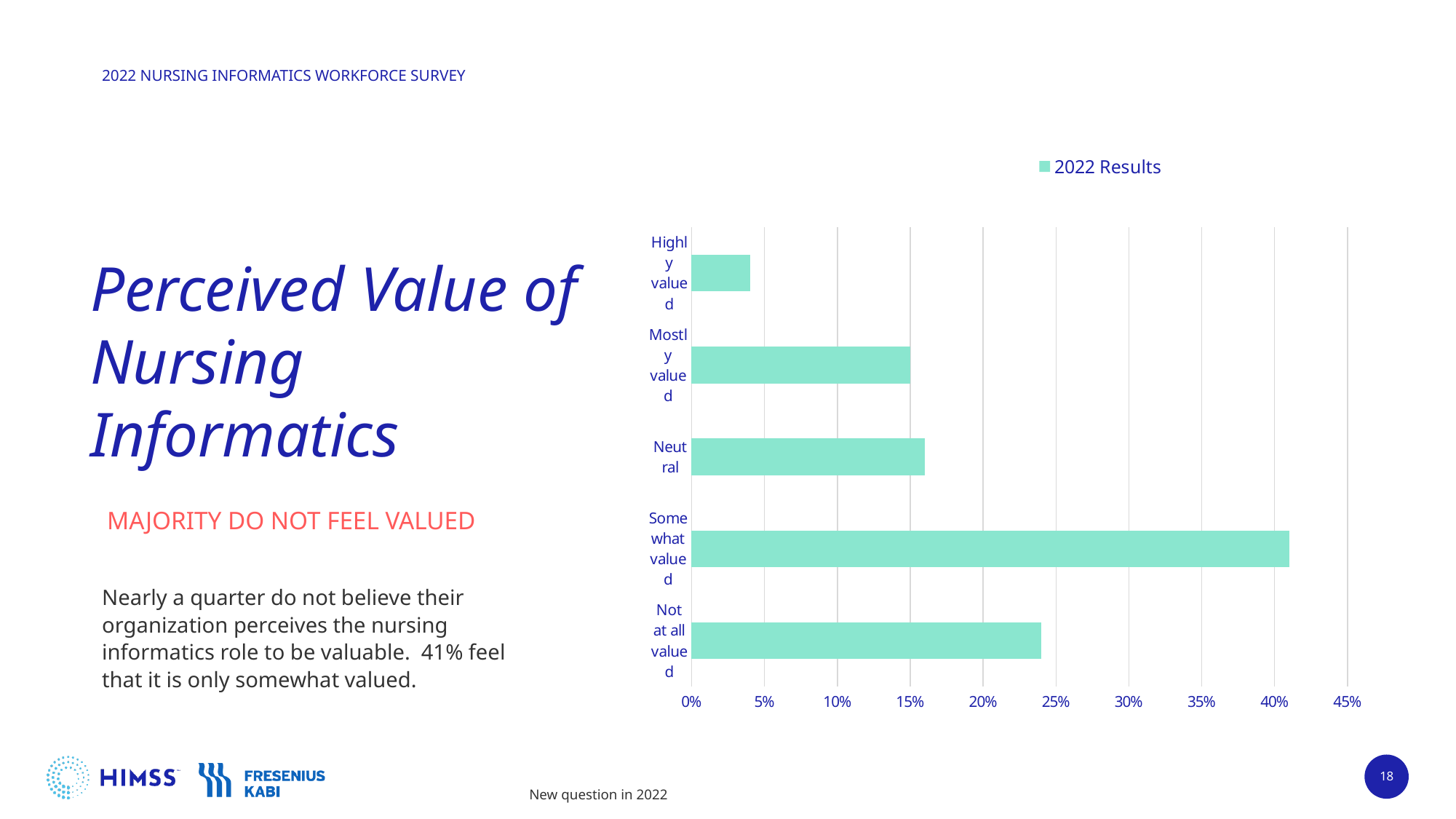
Is the value for Highly valued greater or less than 5%? less What is the value for Somewhat valued? 41% Which category has the lowest value in the chart? Highly valued What series name is shown in the chart legend? 2022 Results Is the value for Neutral greater or less than 20%? less What kind of chart is shown on the slide? bar chart Is the value for Not at all valued greater or less than 20%? greater Which is larger, the value for Not at all valued or the value for Mostly valued? Not at all valued How many categories are plotted in the chart? 5 What is the highest value shown on the chart's horizontal axis? 45% How many series does the chart legend list? 1 Which category has the highest value in the chart? Somewhat valued